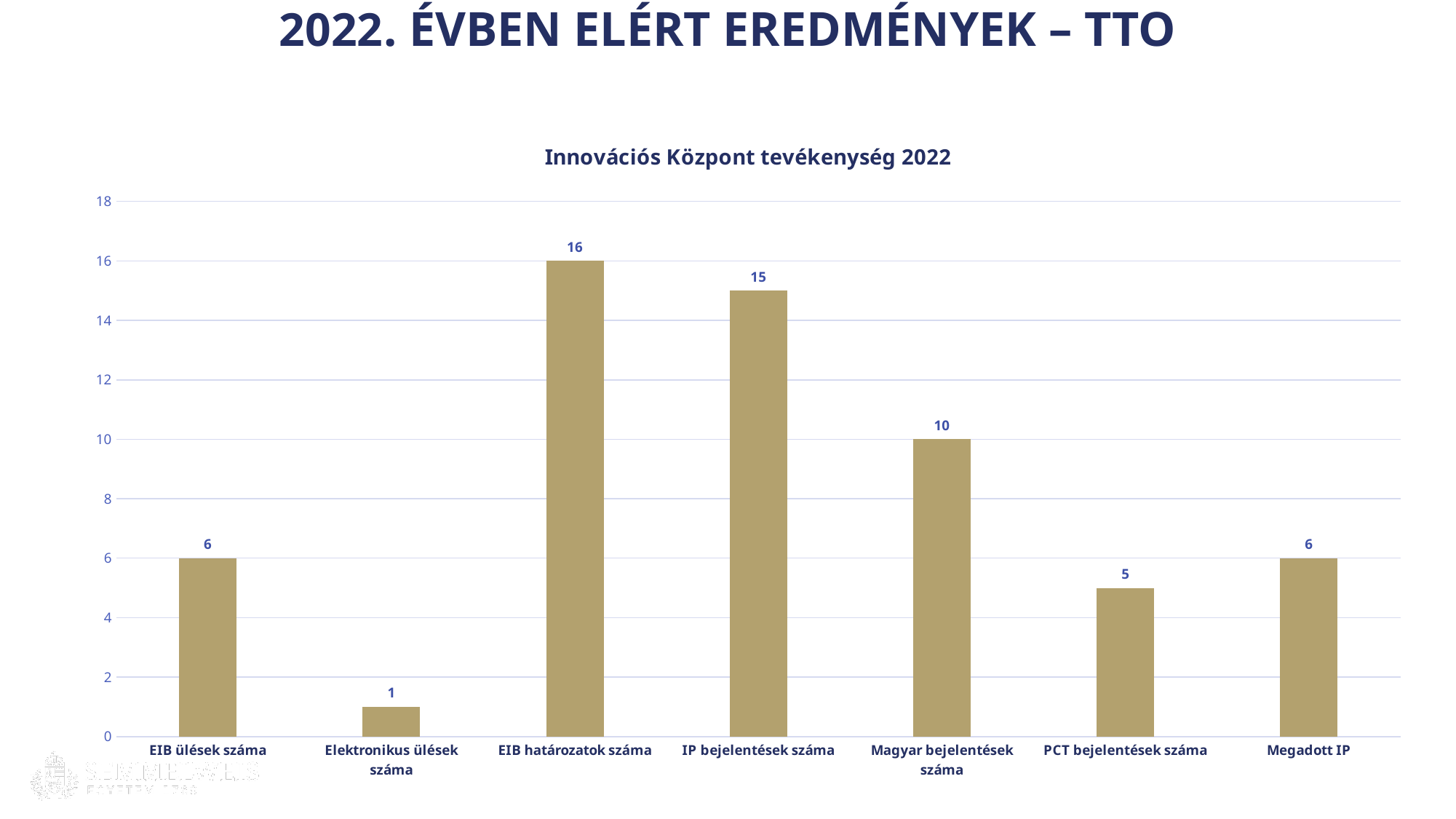
Which is larger, EIB ülések száma or PCT bejelentések száma? EIB ülések száma Is the value for IP bejelentések száma greater or less than 12? greater What is the value for EIB határozatok száma? 16 What is the difference between IP bejelentések száma and Magyar bejelentések száma? 5 What is the value for PCT bejelentések száma? 5 What is the value for Magyar bejelentések száma? 10 What is the value for Elektronikus ülések száma? 1 Which category has the highest value? EIB határozatok száma How many categories are shown on the x axis? 7 What kind of chart is shown? bar chart Which category has the lowest value? Elektronikus ülések száma What is the title of the chart? Innovációs Központ tevékenység 2022